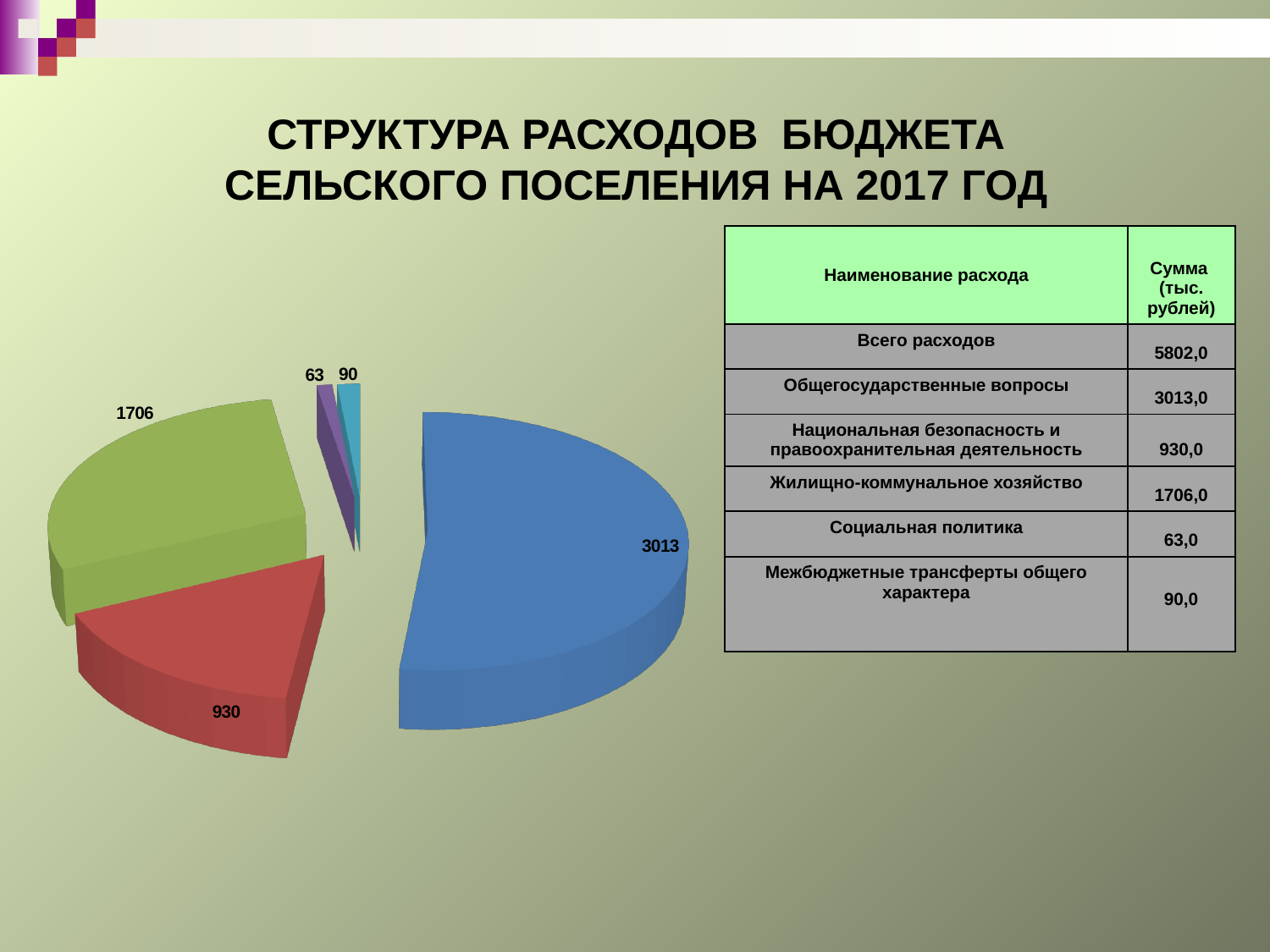
What is the difference between the largest slice (3013) and the green slice (1706) in the pie chart? 1307 What kind of chart is shown on the slide? pie chart Which slice is larger in the pie chart: the red slice (930) or the green slice (1706)? the green slice (1706) How many slices does the pie chart have? 5 What is the value of the smallest slice of the pie chart? 63 What colour is the largest slice of the pie chart? blue What is the sum of all the slice values shown in the pie chart? 5802 What value is labelled on the green slice of the pie chart? 1706 What value is labelled on the red slice of the pie chart? 930 What is the value of the largest slice of the pie chart? 3013 What is the difference between the slices labelled 90 and 63 in the pie chart? 27 What value is labelled on the light blue slice of the pie chart? 90